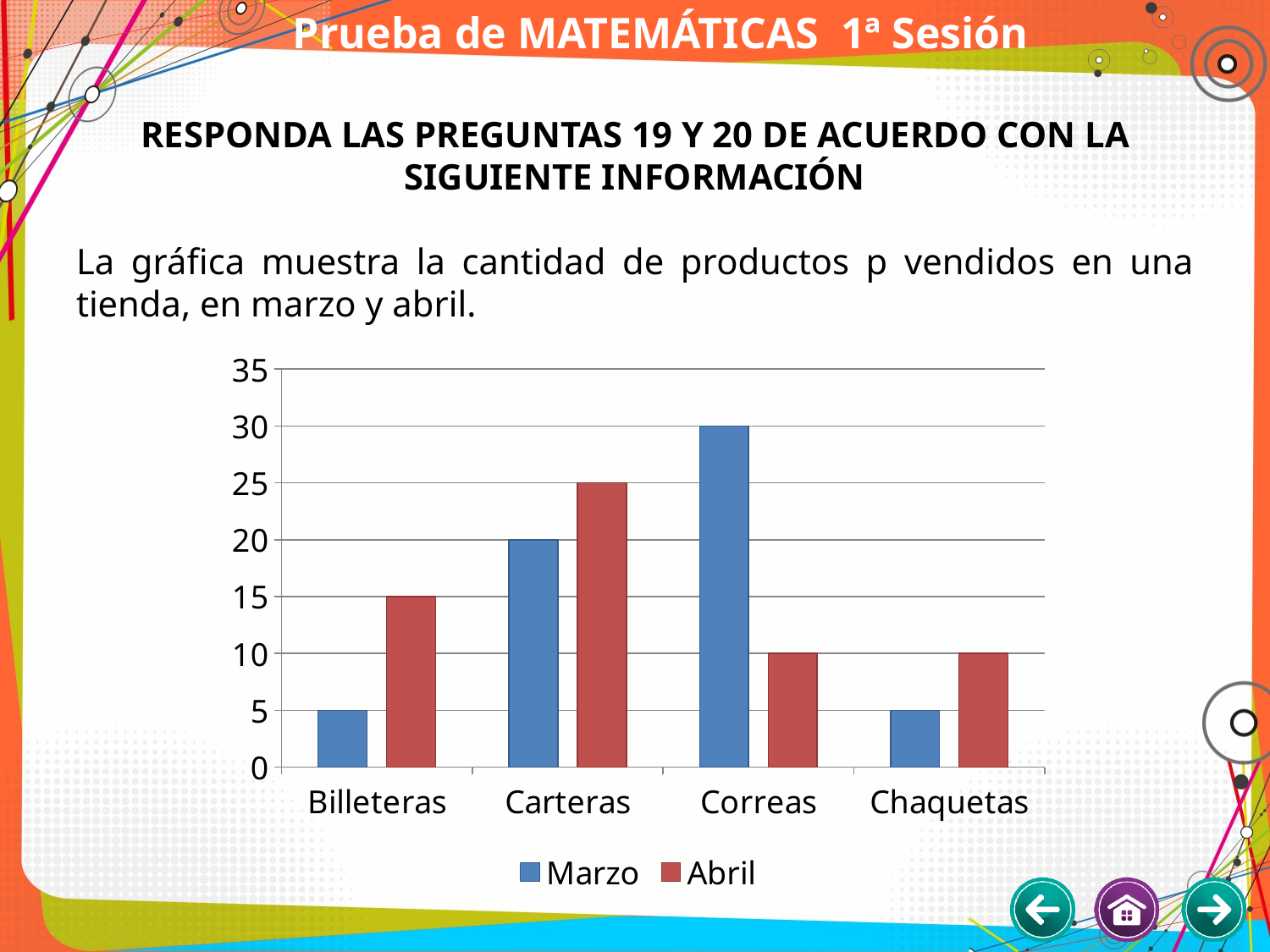
Which series is shown in blue in the legend? Marzo Which category has the highest value in Marzo? Correas Is the value for Carteras in Marzo greater or less than 15? greater What is the value for Carteras in Abril? 25 What kind of chart is shown on the slide? bar chart What is the difference between the Marzo and Abril values for Correas? 20 What is the value for Billeteras in Abril? 15 Which is larger for Billeteras: the Marzo value or the Abril value? Abril What is the value for Correas in Marzo? 30 Which category has the lowest value in Abril? Correas and Chaquetas (both 10) How many series does the legend list? 2 How many product categories are shown on the x axis? 4